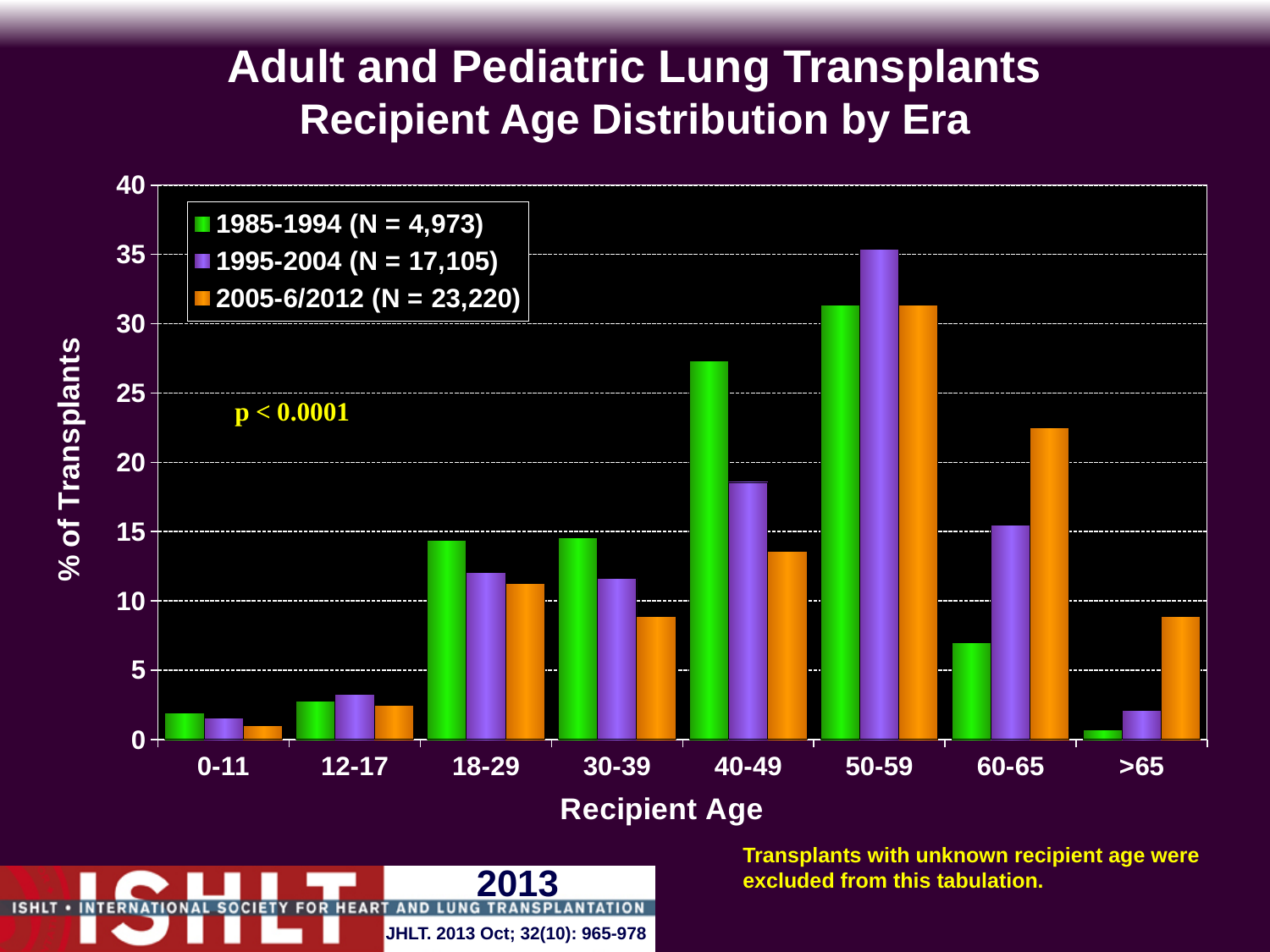
For the 1995-2004 era, which recipient age group has the highest % of transplants? 50-59 In the 40-49 age group, which era has the larger % of transplants: 1985-1994 or 1995-2004? 1985-1994 How many recipient age groups are shown on the x axis? 8 What kind of chart is shown on the slide? bar chart For the 1985-1994 era, which recipient age group has the lowest % of transplants? >65 Is the value for the 2005-6/2012 era in the 60-65 age group greater or less than 20? greater In the 60-65 age group, which era has the larger % of transplants: 1985-1994 or 2005-6/2012? 2005-6/2012 According to the legend, what is the N for the 1995-2004 era? 17,105 Is the value for the 1985-1994 era in the 40-49 age group greater or less than 25? greater For the 2005-6/2012 era, which recipient age group has the highest % of transplants? 50-59 Is the value for the 1995-2004 era in the 50-59 age group greater or less than 30? greater How many series does the legend list? 3